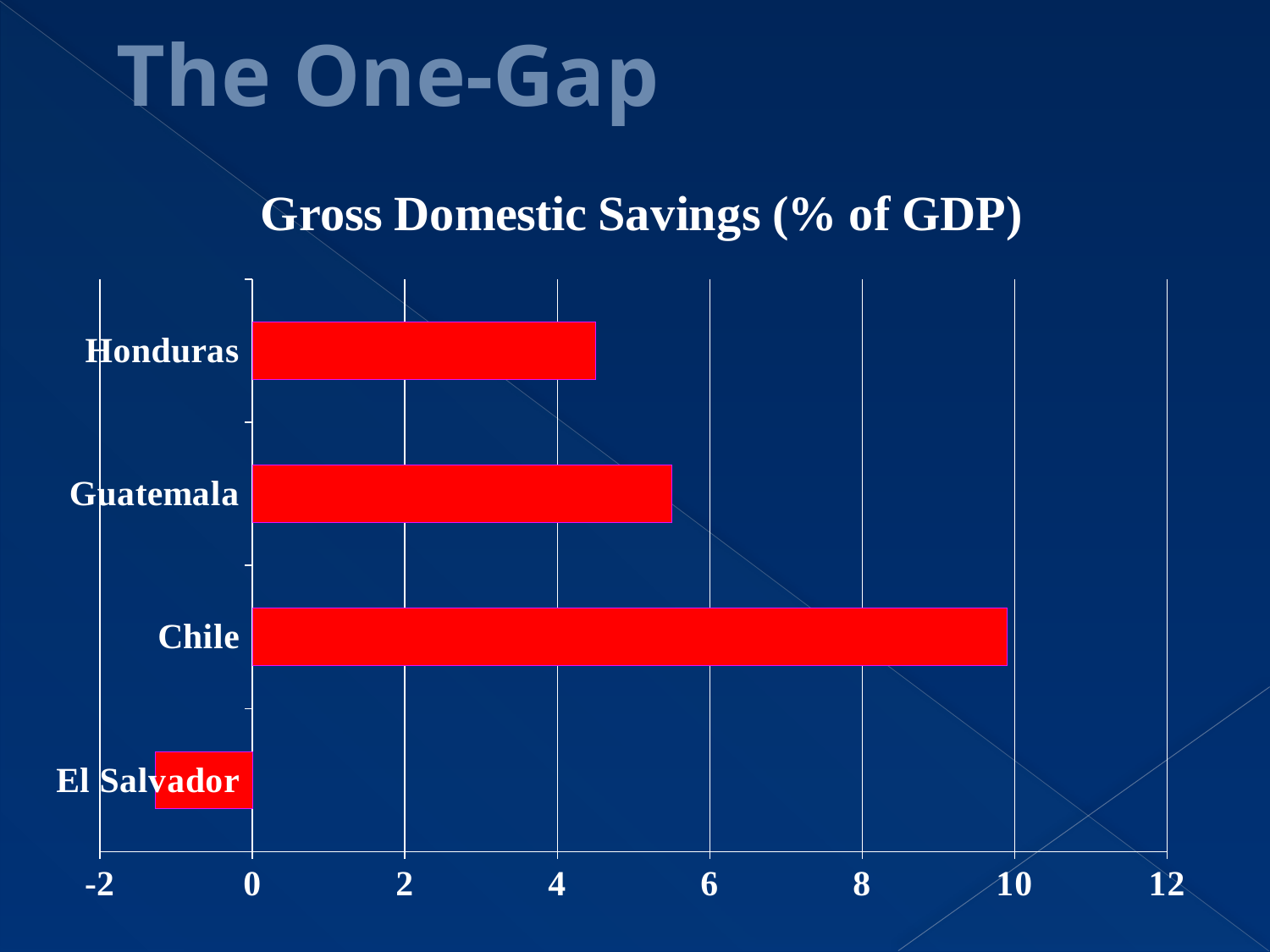
Is the value for El Salvador greater or less than 0? less What is the title of the chart? Gross Domestic Savings (% of GDP) Which country has the highest gross domestic savings as a percentage of GDP? Chile Which country has a higher value, Chile or Guatemala? Chile Is the value for Honduras greater or less than 6? less What colour are the bars in the chart? red How many countries are shown in the chart? 4 Which country has a higher value, Guatemala or Honduras? Guatemala Is the value for Guatemala greater or less than 4? greater What kind of chart is shown on the slide? bar chart Which country has the lowest gross domestic savings as a percentage of GDP? El Salvador